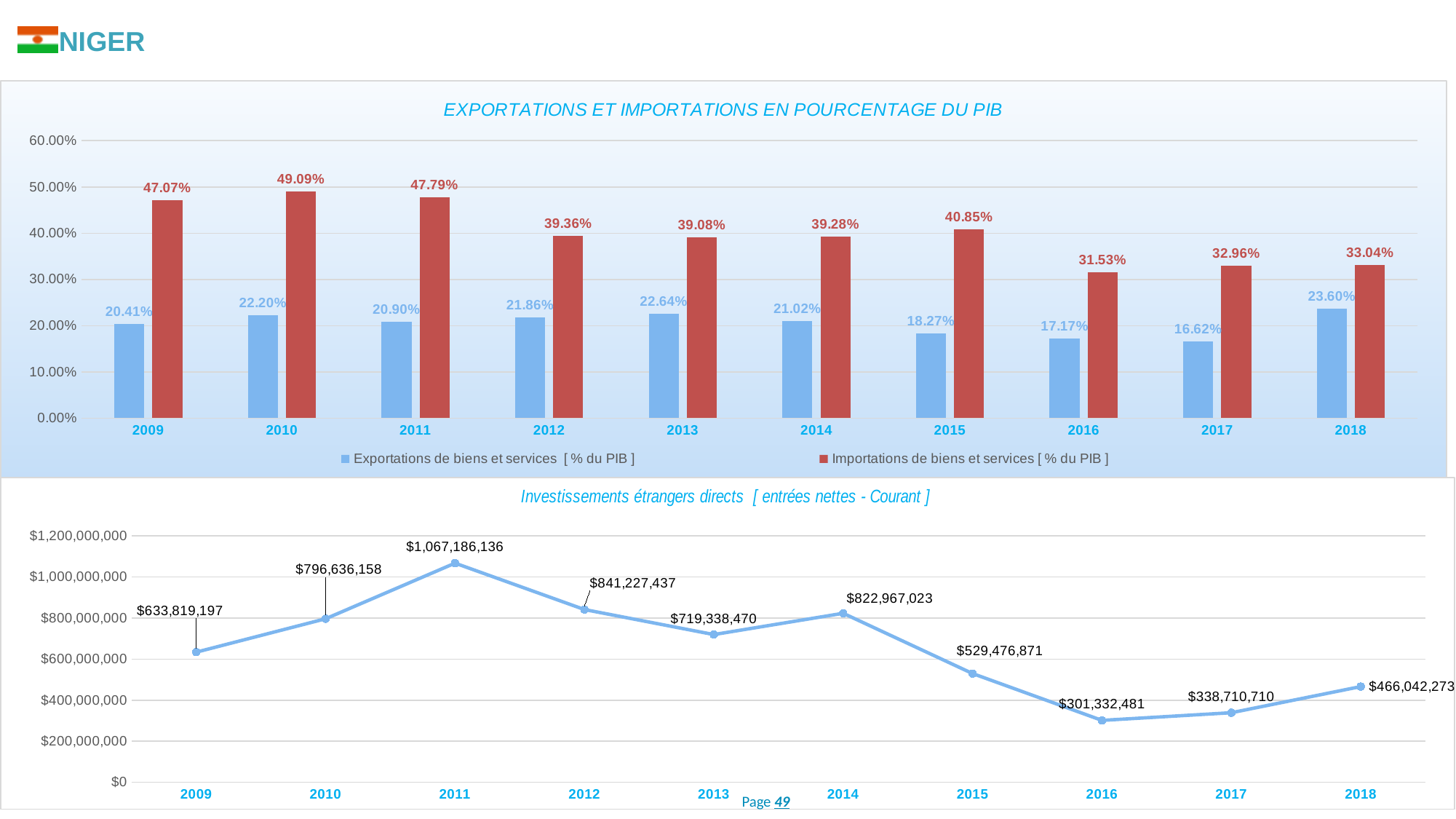
What kind of chart is 'Investissements étrangers directs [ entrées nettes - Courant ]'? Line chart In the chart 'Investissements étrangers directs [ entrées nettes - Courant ]', which year has the lowest value? 2016 In the chart 'Investissements étrangers directs [ entrées nettes - Courant ]', what is the value for 2011? $1,067,186,136 In the chart 'EXPORTATIONS ET IMPORTATIONS EN POURCENTAGE DU PIB', which year has the highest value for Exportations de biens et services? 2018 In the chart 'EXPORTATIONS ET IMPORTATIONS EN POURCENTAGE DU PIB', what is the value of Exportations de biens et services for 2017? 16.62% In the chart 'EXPORTATIONS ET IMPORTATIONS EN POURCENTAGE DU PIB', what is the difference between Importations and Exportations in 2009? 26.66% How many series does the legend of the chart 'EXPORTATIONS ET IMPORTATIONS EN POURCENTAGE DU PIB' list? 2 In the chart 'EXPORTATIONS ET IMPORTATIONS EN POURCENTAGE DU PIB', what is the value of Importations de biens et services for 2010? 49.09% How many years are plotted in the chart 'Investissements étrangers directs [ entrées nettes - Courant ]'? 10 In the chart 'Investissements étrangers directs [ entrées nettes - Courant ]', which year has the larger value, 2010 or 2014? 2014 In the chart 'Investissements étrangers directs [ entrées nettes - Courant ]', do the values rise or fall from 2014 to 2016? Fall In the chart 'EXPORTATIONS ET IMPORTATIONS EN POURCENTAGE DU PIB', which year has the lowest value for Importations de biens et services? 2016